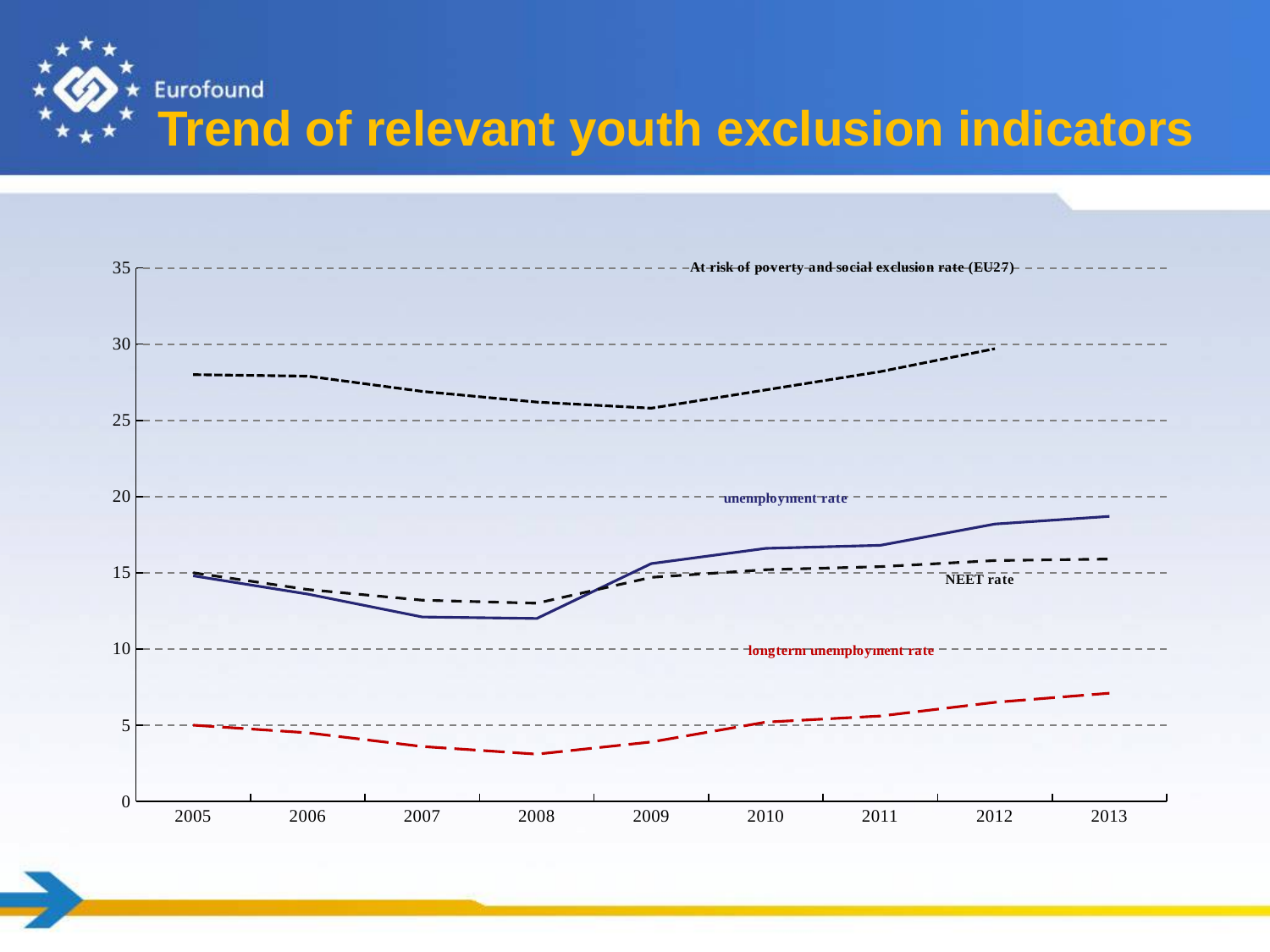
How many years are shown along the x axis? 9 Is the unemployment rate in 2013 greater or less than 15? greater In which year is the unemployment rate highest? 2013 Is the longterm unemployment rate in 2008 greater or less than 5? less Is the at risk of poverty and social exclusion rate (EU27) in 2012 greater or less than 25? greater How many series are plotted on the chart? 4 Does the unemployment rate rise or fall between 2009 and 2013? rise What colour is the longterm unemployment rate line? red In 2013, which is higher: the unemployment rate or the NEET rate? unemployment rate What kind of chart is shown on the slide? line chart Which series has the lowest values across the whole period? longterm unemployment rate Which series has the highest values across the whole period? At risk of poverty and social exclusion rate (EU27)